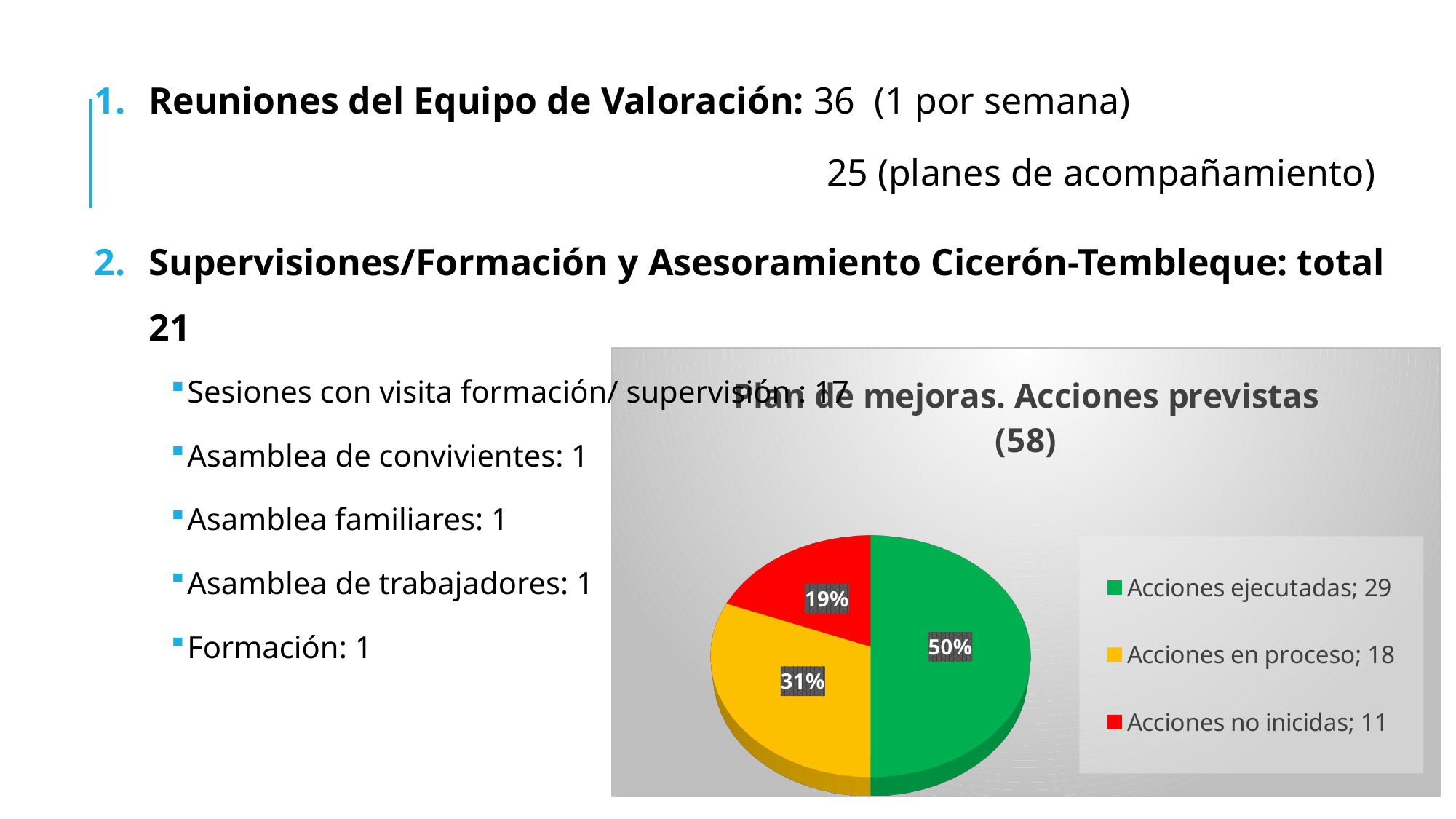
According to the legend, how many 'Acciones ejecutadas' are there? 29 According to the legend, how many 'Acciones no inicidas' are there? 11 Which category has the largest slice of the pie? Acciones ejecutadas How many slices does the pie chart have? 3 What is the title of the chart? Plan de mejoras. Acciones previstas (58) According to the legend, how many 'Acciones en proceso' are there? 18 Which category has the smallest slice of the pie? Acciones no inicidas What percentage of the pie does 'Acciones en proceso' represent? 31% What kind of chart is shown on the slide? pie chart What percentage of the pie does 'Acciones ejecutadas' represent? 50% What percentage of the pie does 'Acciones no inicidas' represent? 19% What is the difference between the number of 'Acciones ejecutadas' and 'Acciones no inicidas'? 18